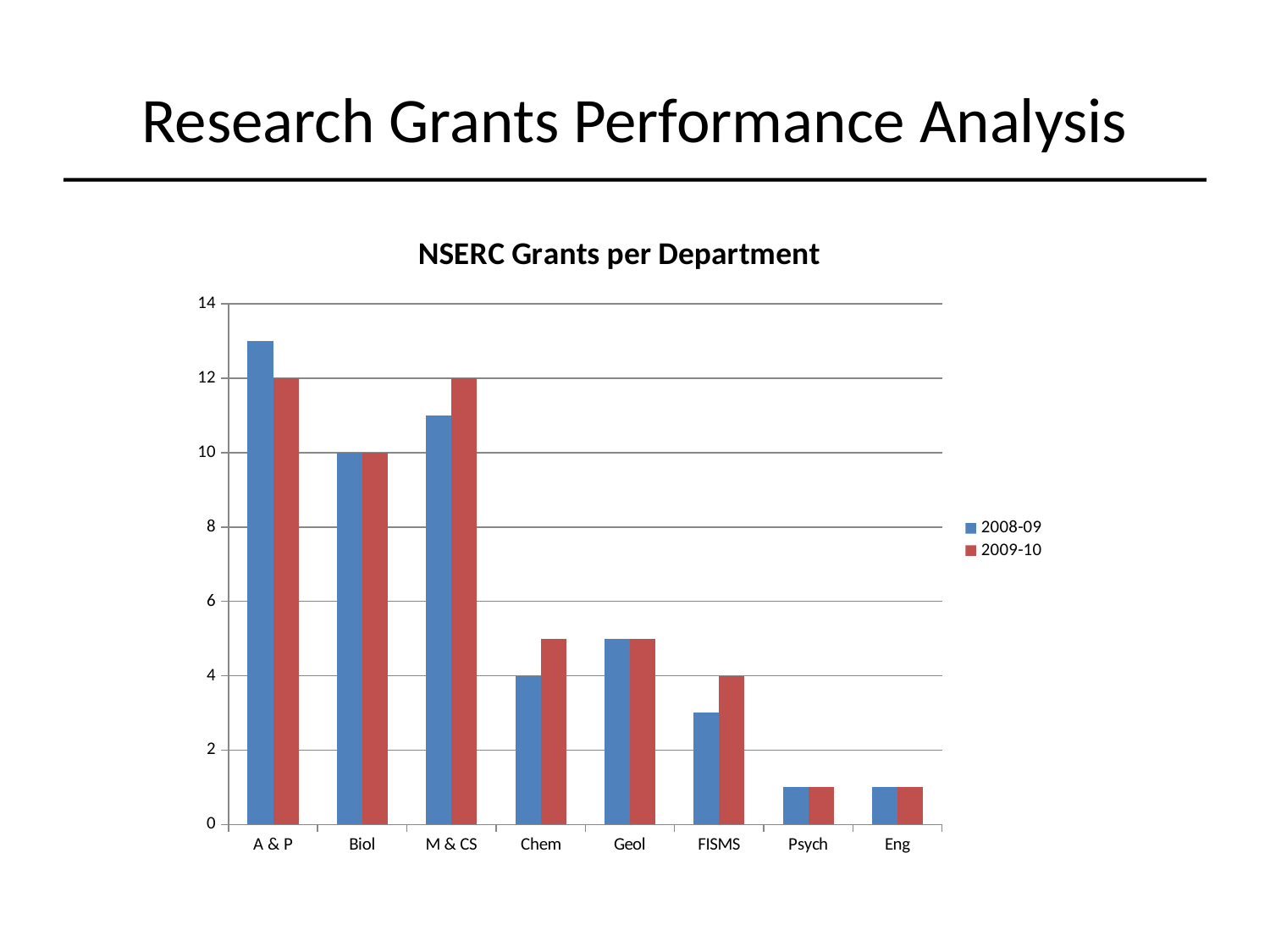
What is the 2009-10 value for M & CS? 12 What is the 2008-09 value for Biol? 10 Is the 2008-09 value for A & P greater or less than 12? greater What is the difference between the 2009-10 value for M & CS and the 2009-10 value for Biol? 2 What is the 2009-10 value for FISMS? 4 What type of chart is shown on the slide? bar chart Is the 2009-10 value for Psych greater or less than 2? less How many departments are shown on the x axis? 8 How many series does the legend list? 2 What is the title of the chart? NSERC Grants per Department What is the 2008-09 value for Chem? 4 Which department has the highest 2008-09 value? A & P